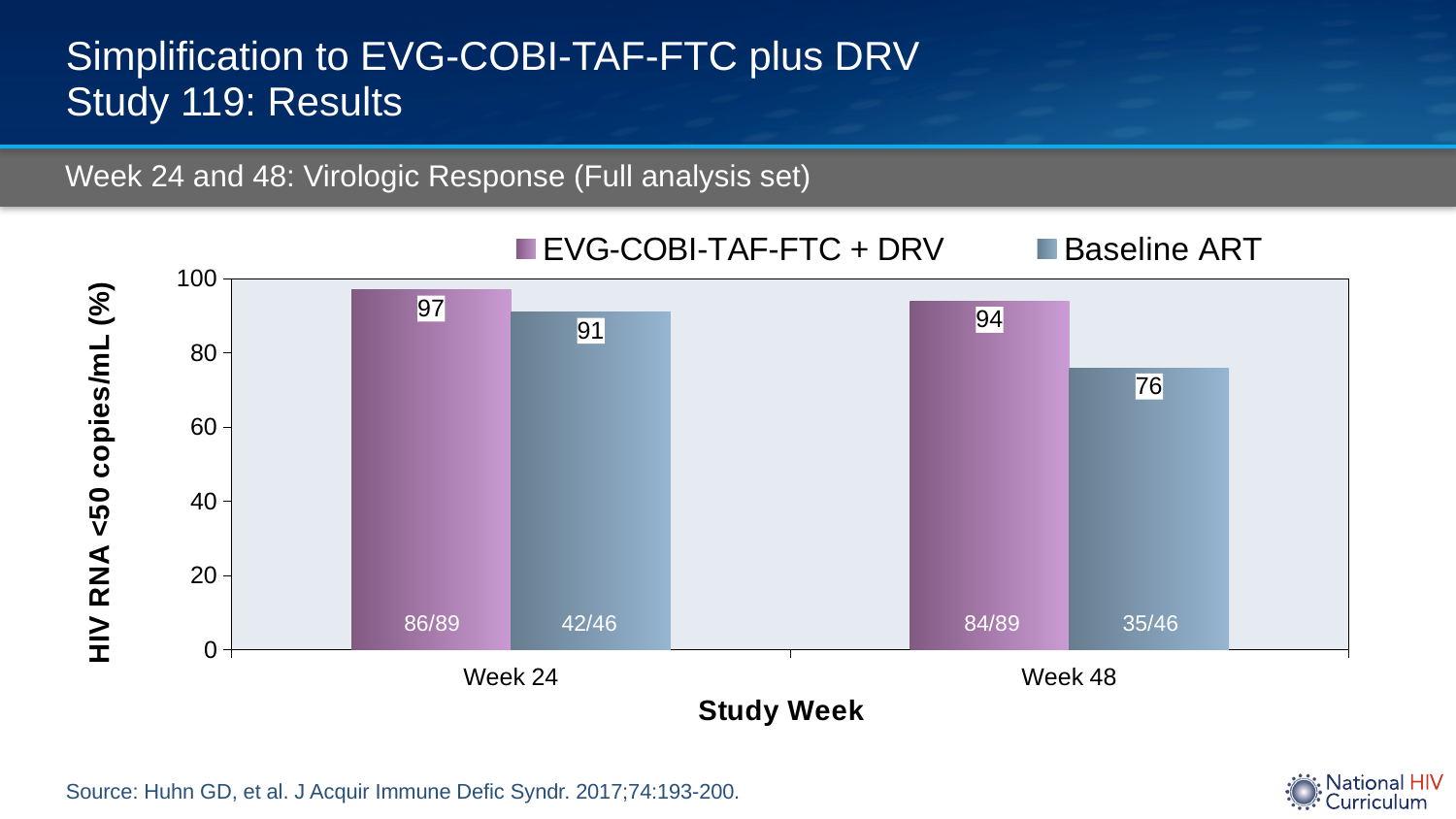
What is the value for Baseline ART at Week 24? 91 Does the Baseline ART value rise or fall from Week 24 to Week 48? Fall What is the difference between EVG-COBI-TAF-FTC + DRV and Baseline ART at Week 48? 18 What kind of chart is shown on the slide? Bar chart Which is larger at Week 24: EVG-COBI-TAF-FTC + DRV or Baseline ART? EVG-COBI-TAF-FTC + DRV Which bar has the lowest value on the chart? Baseline ART at Week 48 What is the value for EVG-COBI-TAF-FTC + DRV at Week 48? 94 Which bar has the highest value on the chart? EVG-COBI-TAF-FTC + DRV at Week 24 How many series does the legend list? 2 What is the value for Baseline ART at Week 48? 76 What is the value for EVG-COBI-TAF-FTC + DRV at Week 24? 97 How many study week categories are shown on the x axis? 2